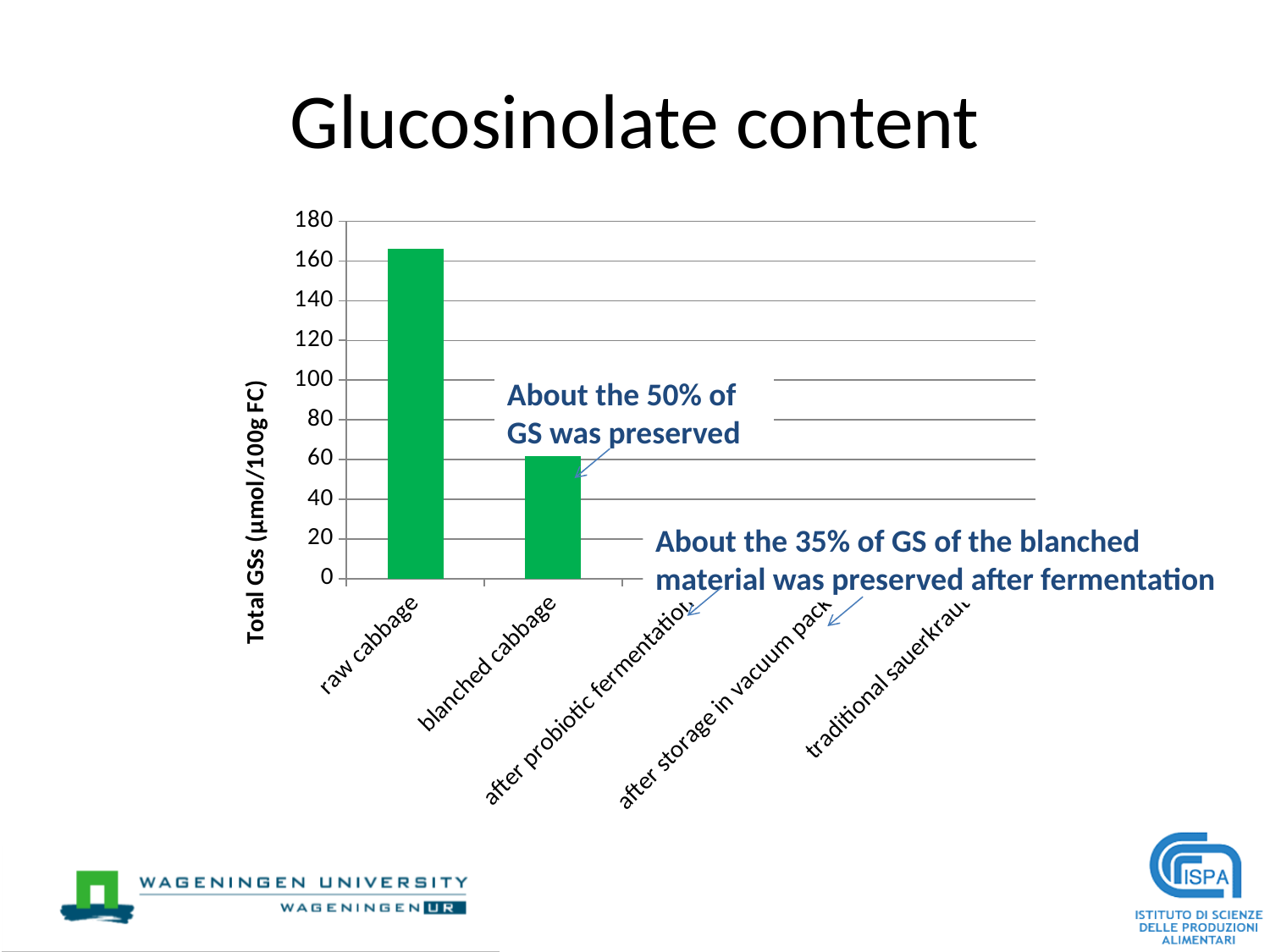
Is the value for blanched cabbage greater or less than 40? greater What colour are the bars in the chart? green Do the bar values rise or fall from raw cabbage to blanched cabbage? fall Is the value for raw cabbage greater or less than 140? greater Is the value for blanched cabbage greater or less than 80? less How many bars are actually plotted in the chart? 2 What kind of chart is shown on the slide? bar chart Which category has the highest bar in the chart? raw cabbage What is the label of the y axis of the chart? Total GSs (µmol/100g FC) How many categories are labelled on the x axis of the chart? 5 Which is larger, the value for raw cabbage or the value for blanched cabbage? raw cabbage